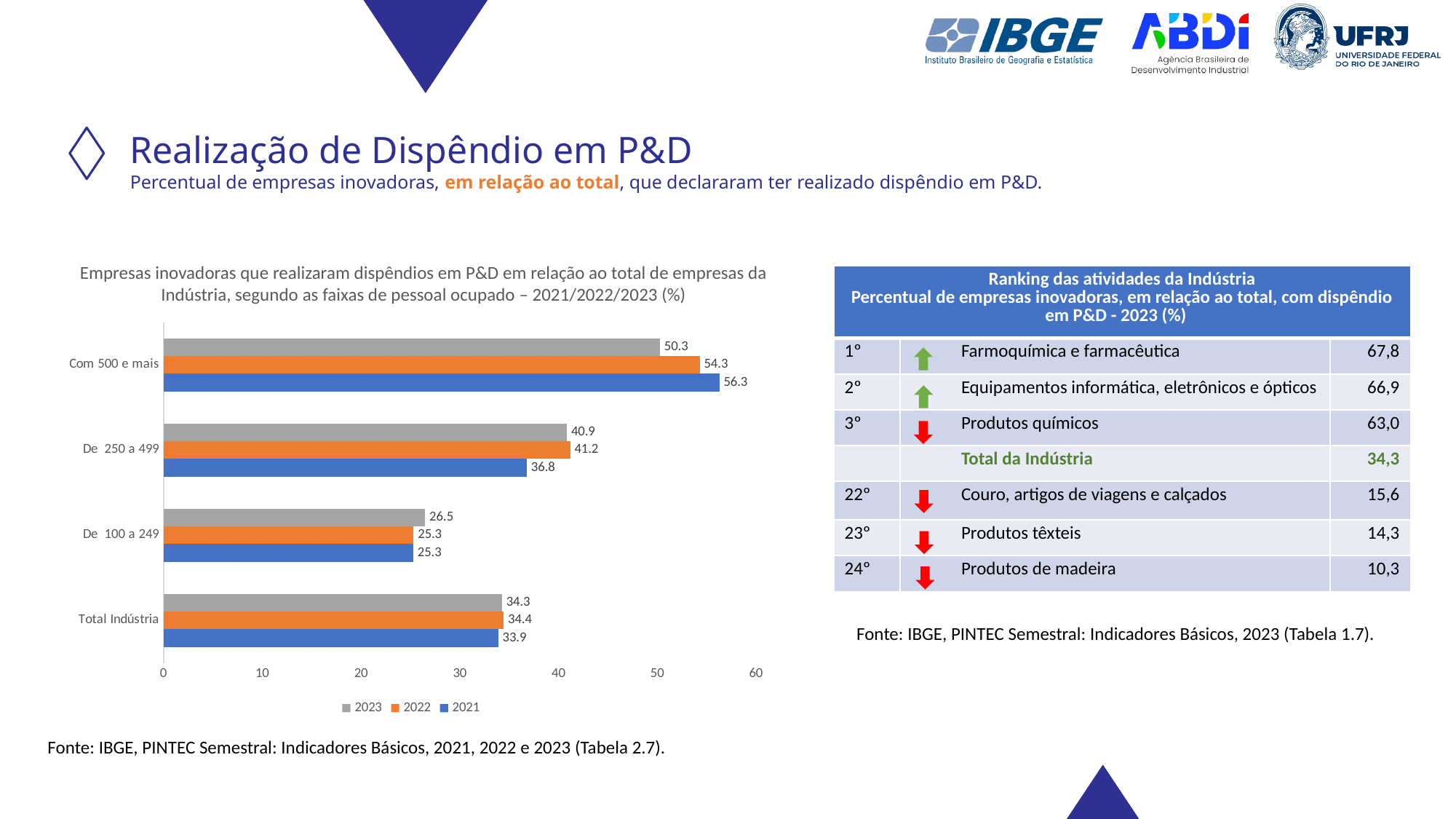
What is the 2022 value for 'Total Indústria' in the bar chart? 34.4 Which category has the highest 2023 value in the bar chart? Com 500 e mais How many categories are shown on the vertical axis of the bar chart? 4 What is the difference between the 2021 and 2023 values for 'Com 500 e mais' in the bar chart? 6.0 Which colour represents 2022 in the bar chart? orange What is the 2021 value for 'Com 500 e mais' in the bar chart? 56.3 Which category has the lowest 2021 value in the bar chart? De 100 a 249 What type of chart is shown on the left of the slide? bar chart Is the 2023 value for 'De 100 a 249' in the bar chart greater or less than 30? less What is the 2023 value for 'De 250 a 499' in the bar chart? 40.9 How many series does the legend of the bar chart list? 3 In the bar chart, is the 2022 value for 'De 250 a 499' larger or smaller than its 2021 value? larger